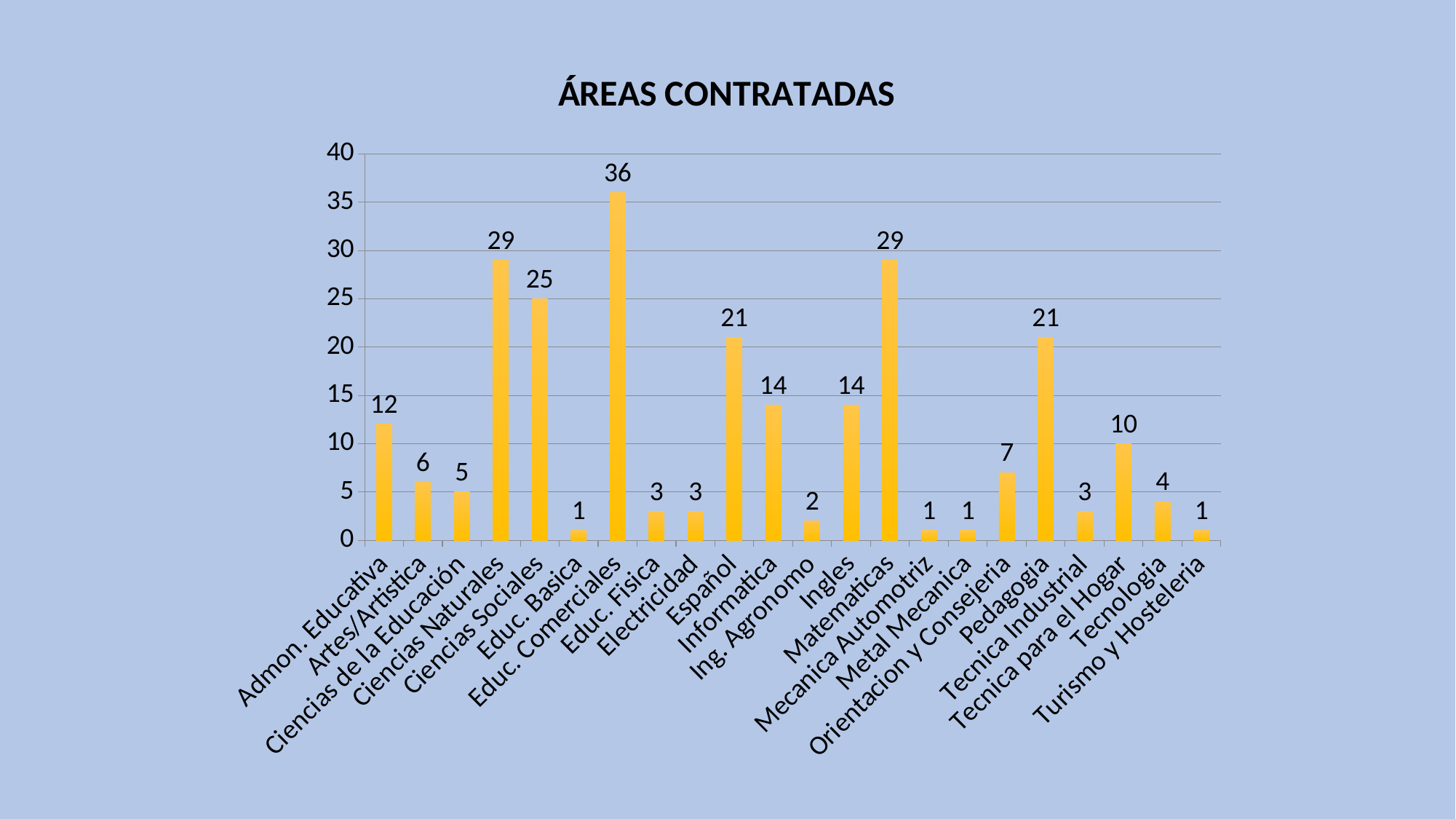
What is the value for Ciencias Sociales? 25 What is the value for Orientacion y Consejeria? 7 Which category has the highest value? Educ. Comerciales What is the difference between the values for Español and Informatica? 7 Which is larger, the value for Admon. Educativa or the value for Tecnica para el Hogar? Admon. Educativa What kind of chart is shown on the slide? Bar chart How many categories are shown on the chart? 22 What is the value for Educ. Comerciales? 36 What is the title of the chart? ÁREAS CONTRATADAS What is the lowest value shown on the chart? 1 What is the difference between the values for Educ. Comerciales and Matematicas? 7 What is the value for Tecnica para el Hogar? 10